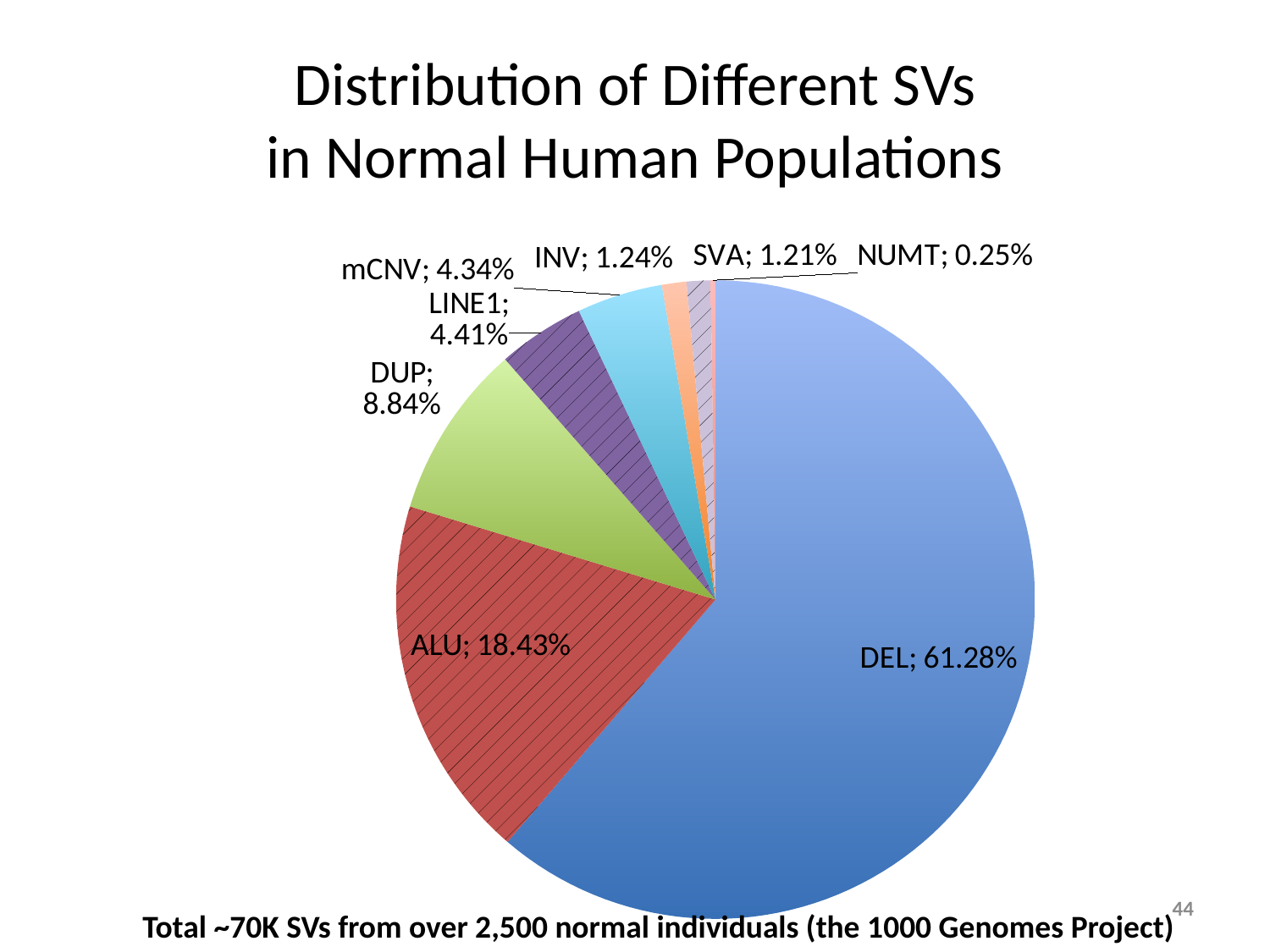
What share of SVs is ALU? 18.43% What share of SVs is DUP? 8.84% Which SV type has the largest share of the pie? DEL What share of SVs is LINE1? 4.41% What is the difference between the DEL share and the ALU share? 42.85% What share of SVs is DEL? 61.28% What kind of chart is shown on the slide? pie chart How many SV categories are shown in the pie chart? 8 Which is larger, the share for DUP or the share for mCNV? DUP What share of SVs is NUMT? 0.25% What is the title of the chart? Distribution of Different SVs in Normal Human Populations Which SV type has the smallest share of the pie? NUMT